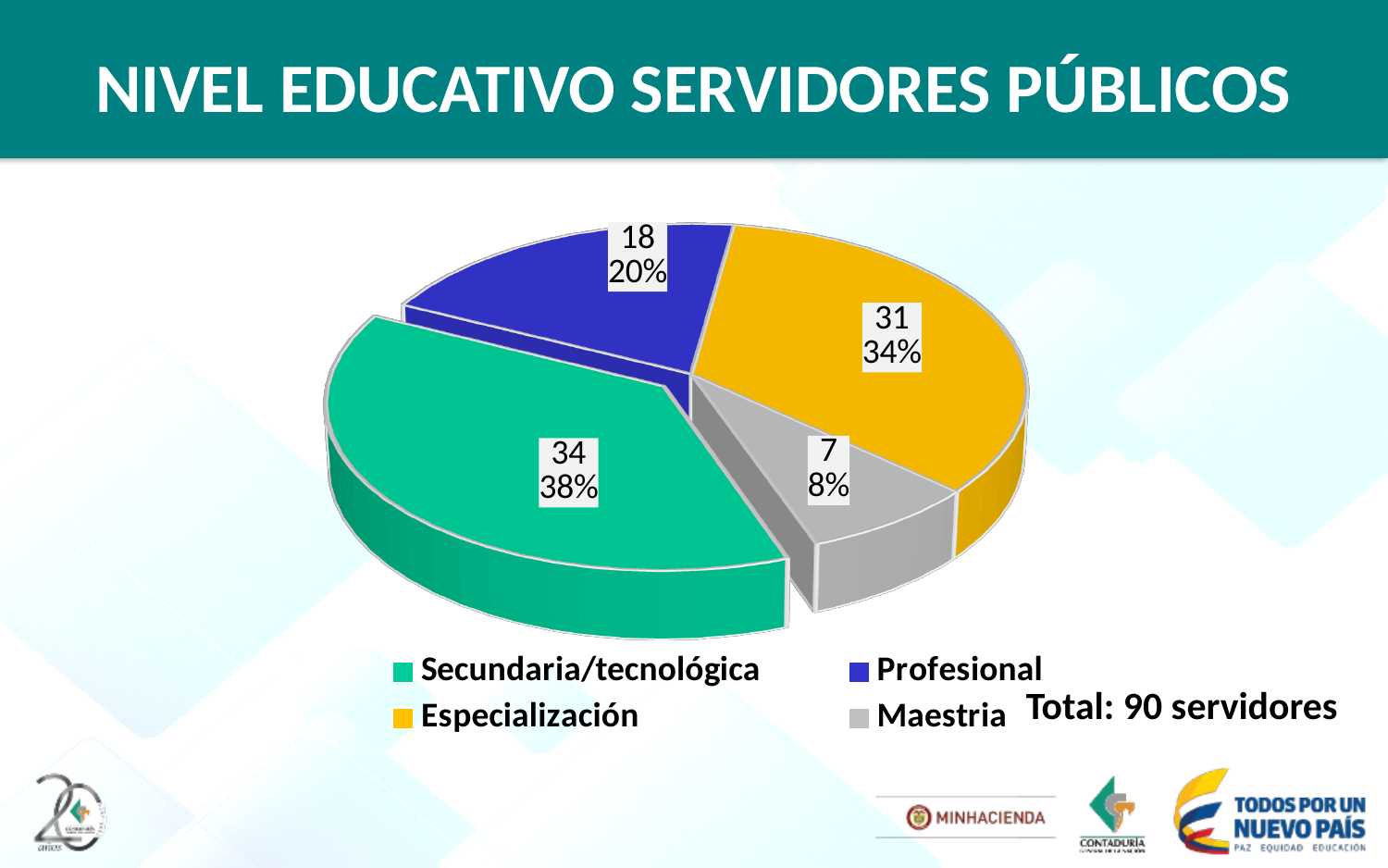
Which has more servidores, Profesional or Maestria? Profesional How many servidores have a Maestria? 7 What is the difference in number of servidores between Especialización and Profesional? 13 What kind of chart is shown on the slide? pie chart Which category has the largest slice of the pie? Secundaria/tecnológica How many categories does the pie chart have? 4 What is the total number of servidores stated on the slide? 90 What share of the pie is the Profesional slice? 20% What percentage of the pie does Especialización represent? 34% Which category has the smallest slice of the pie? Maestria What colour is the Especialización slice? yellow How many servidores are in the Secundaria/tecnológica category? 34